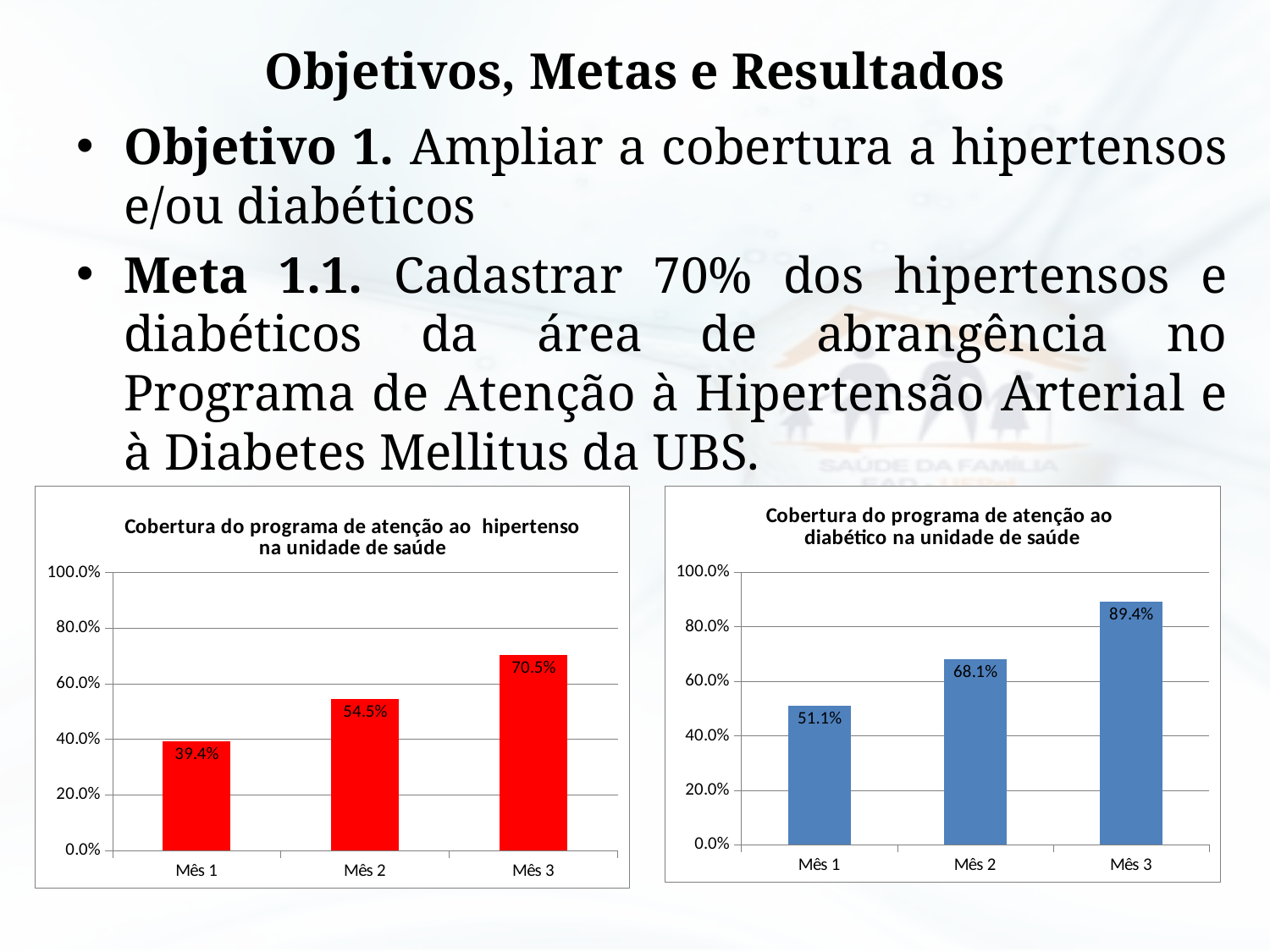
What colour are the bars in the left chart (hipertenso)? Red In the right chart (Cobertura do programa de atenção ao diabético na unidade de saúde), what is the value for Mês 3? 89.4% How many months are shown on the x axis of the right chart (diabético)? 3 In the right chart (diabético), what is the difference between the values for Mês 2 and Mês 1? 17.0% In the left chart (Cobertura do programa de atenção ao hipertenso na unidade de saúde), what is the value for Mês 2? 54.5% What kind of chart is the left chart (hipertenso)? Bar chart In the right chart (diabético), do the values rise or fall from Mês 1 to Mês 3? Rise In the left chart (hipertenso), which month has the lowest value? Mês 1 Which is larger: the Mês 1 value in the left chart (hipertenso) or the Mês 1 value in the right chart (diabético)? The right chart (diabético), 51.1% In the left chart (hipertenso), is the value for Mês 3 greater or less than 80.0%? less In the left chart (hipertenso), what is the difference between the values for Mês 3 and Mês 1? 31.1% In the right chart (diabético), which month has the highest value? Mês 3